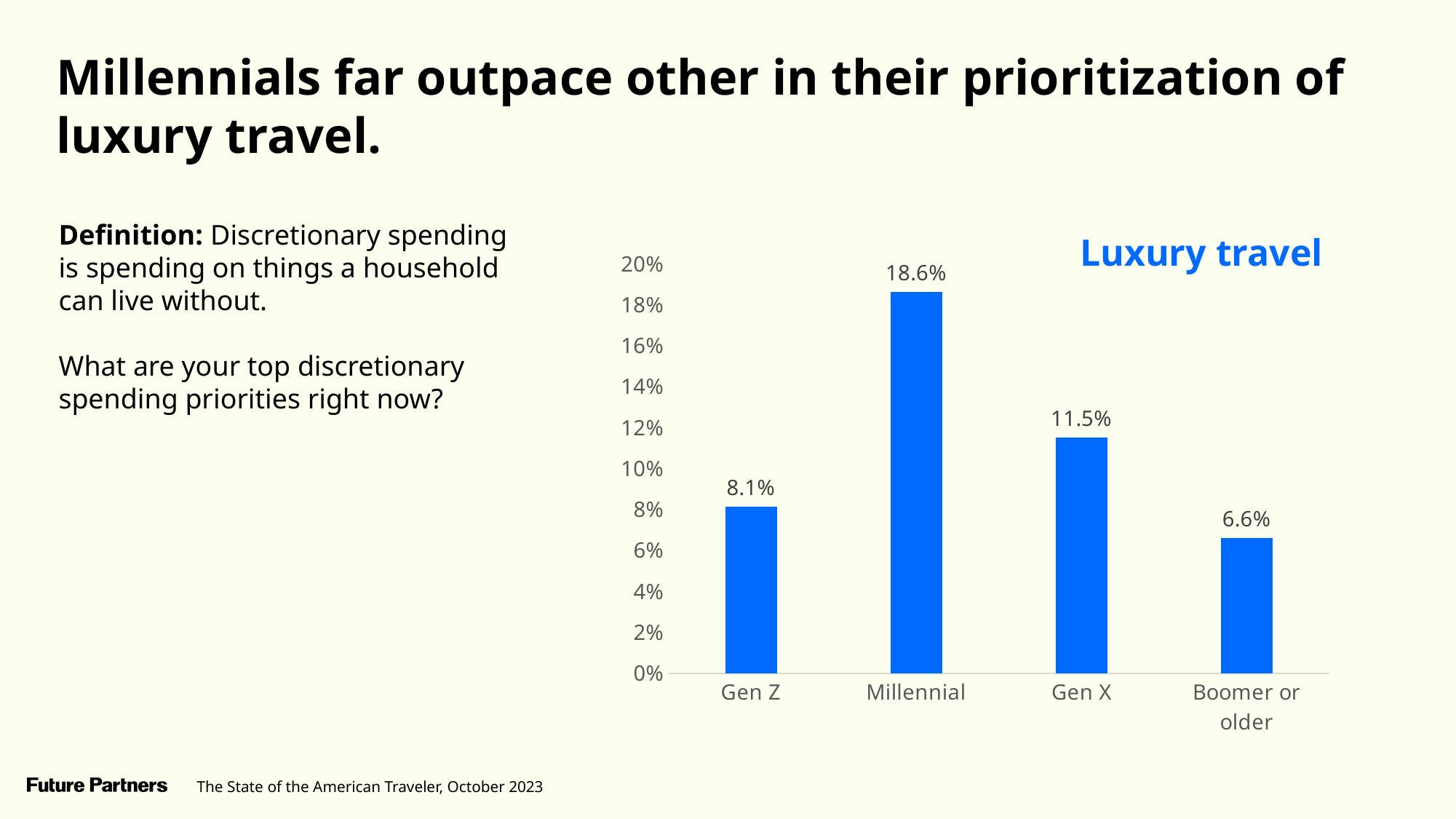
What is the value for Millennial in the Luxury travel chart? 18.6% What is the difference between the Millennial and Gen X values in the Luxury travel chart? 7.1% What is the value for Boomer or older in the Luxury travel chart? 6.6% What kind of chart is shown on the slide? Bar chart What is the difference between the Gen Z and Boomer or older values in the Luxury travel chart? 1.5% Is the value for Gen X in the Luxury travel chart greater or less than 10%? greater Which is larger in the Luxury travel chart, the value for Gen X or the value for Gen Z? Gen X What is the value for Gen Z in the Luxury travel chart? 8.1% What is the title of the chart on the slide? Luxury travel Which generation has the highest value in the Luxury travel chart? Millennial How many generation categories are shown in the Luxury travel chart? 4 Which generation has the lowest value in the Luxury travel chart? Boomer or older